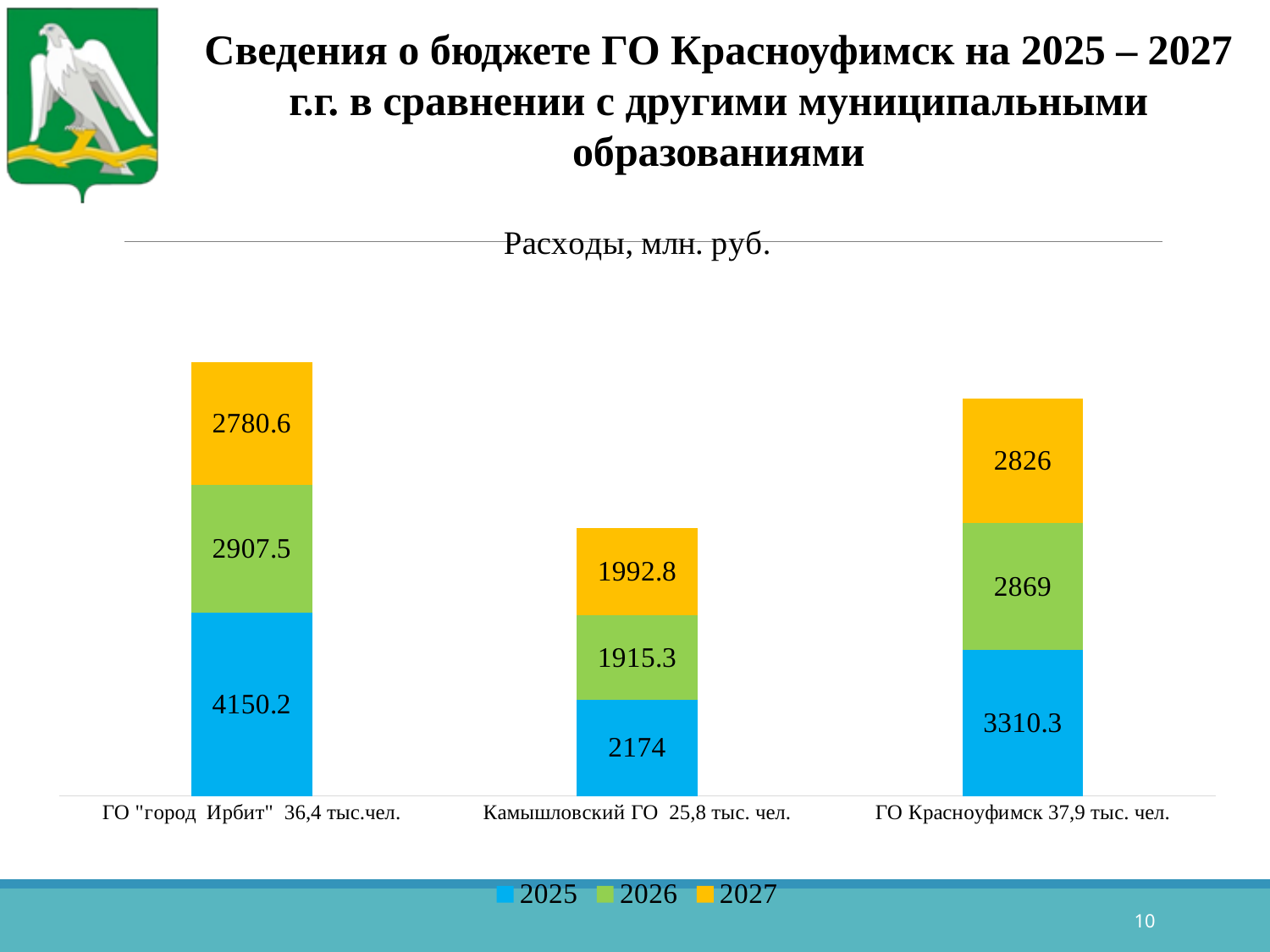
What is the title of the chart? Расходы, млн. руб. Which municipality has the lowest total stacked bar? Камышловский ГО What is the 2027 value for Камышловский ГО? 1992.8 How many series does the legend list? 3 What is the difference between the 2025 values for ГО "город Ирбит" and ГО Красноуфимск? 839.9 How many municipalities (categories) are shown on the x axis? 3 What is the total of the stacked bar for Камышловский ГО? 6082.1 Which municipality has the highest 2025 value? ГО "город Ирбит" What is the 2026 value for ГО "город Ирбит"? 2907.5 What type of chart is shown on the slide? stacked bar chart Which is larger: the 2027 value for ГО Красноуфимск or the 2027 value for ГО "город Ирбит"? ГО Красноуфимск What is the 2025 value for ГО Красноуфимск? 3310.3